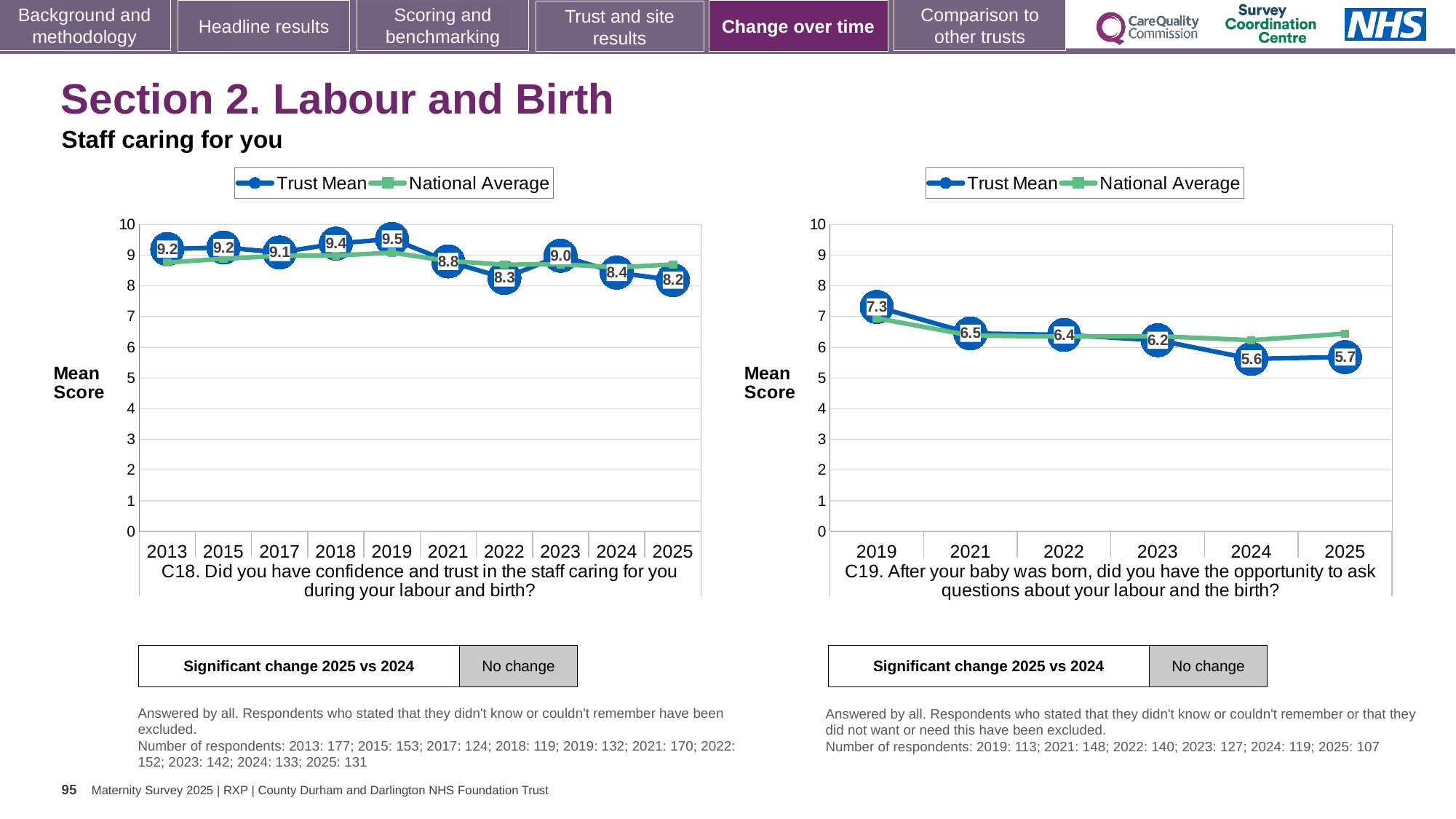
In the C19 chart (right), does the Trust Mean generally rise or fall from 2019 to 2025? fall In the C19 chart (right), which year has the lowest Trust Mean score? 2024 In the C18 chart (left), which year has the lowest Trust Mean score? 2025 In the C19 chart (right), what is the Trust Mean score for 2019? 7.3 In the C18 chart (left), which year has the highest Trust Mean score? 2019 In the C18 chart (left), what is the Trust Mean score for 2019? 9.5 In the C18 chart (left), what is the difference between the Trust Mean scores for 2019 and 2022? 1.2 How many series does the legend of the C19 chart (right) list? 2 In the C19 chart (right), is the National Average for 2025 greater or less than 6? greater In the C19 chart (right), is the Trust Mean score for 2021 or 2024 larger? 2021 In the C18 chart (left), how many years are shown on the x axis? 10 In the C18 chart (left), what is the Trust Mean score for 2025? 8.2